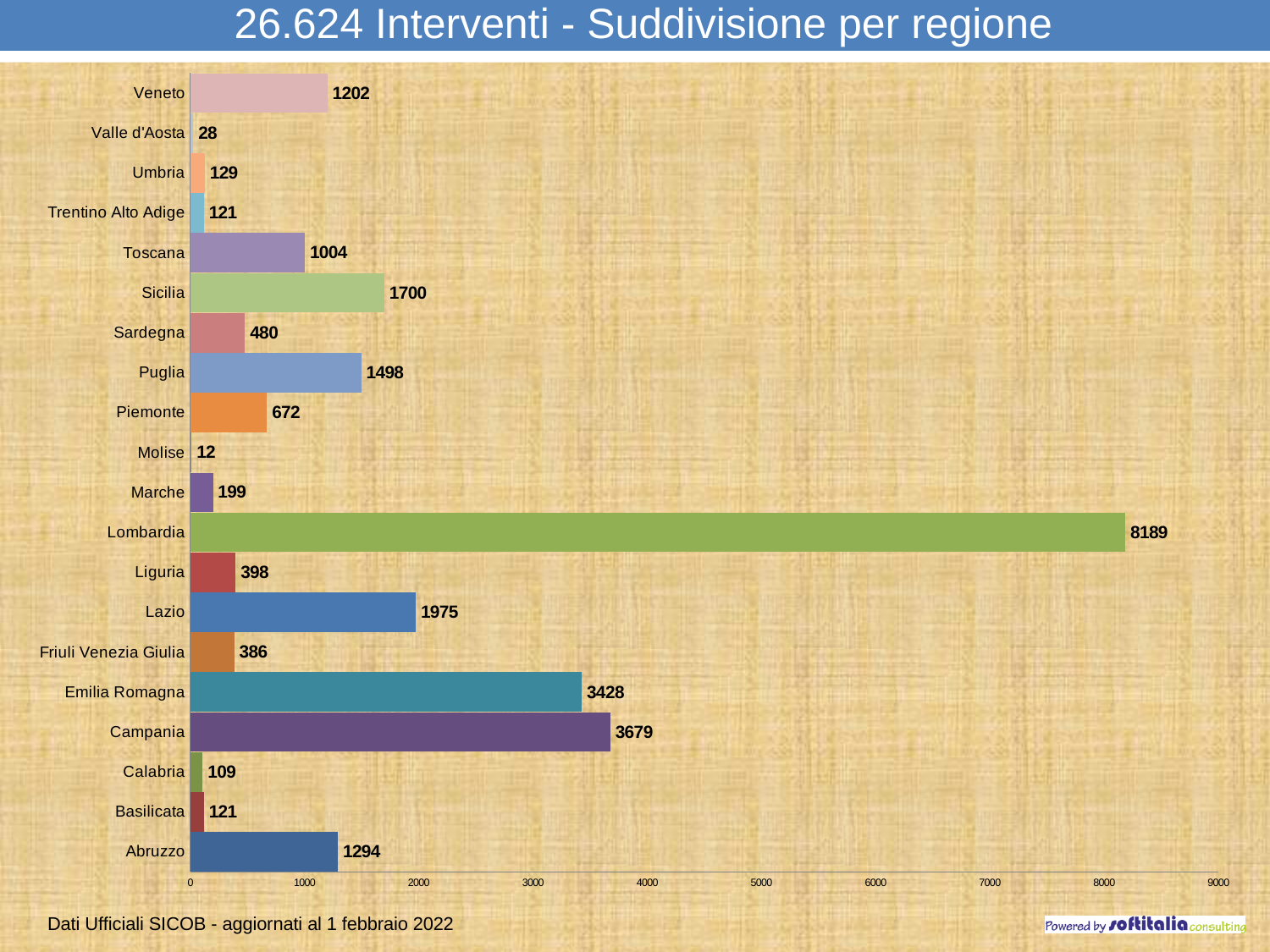
What is the value for Sardegna? 480 Which region has the highest value? Lombardia Is the value for Puglia greater or less than 1000? greater Which region has the lowest value? Molise What is the value for Emilia Romagna? 3428 What is the value for Lombardia? 8189 What kind of chart is shown on the slide? Bar chart Which has a larger value, Lazio or Sicilia? Lazio What is the difference between the values for Campania and Emilia Romagna? 251 What is the title of the chart? 26.624 Interventi - Suddivisione per regione How many regions are shown in the chart? 20 What is the difference between the values for Veneto and Toscana? 198